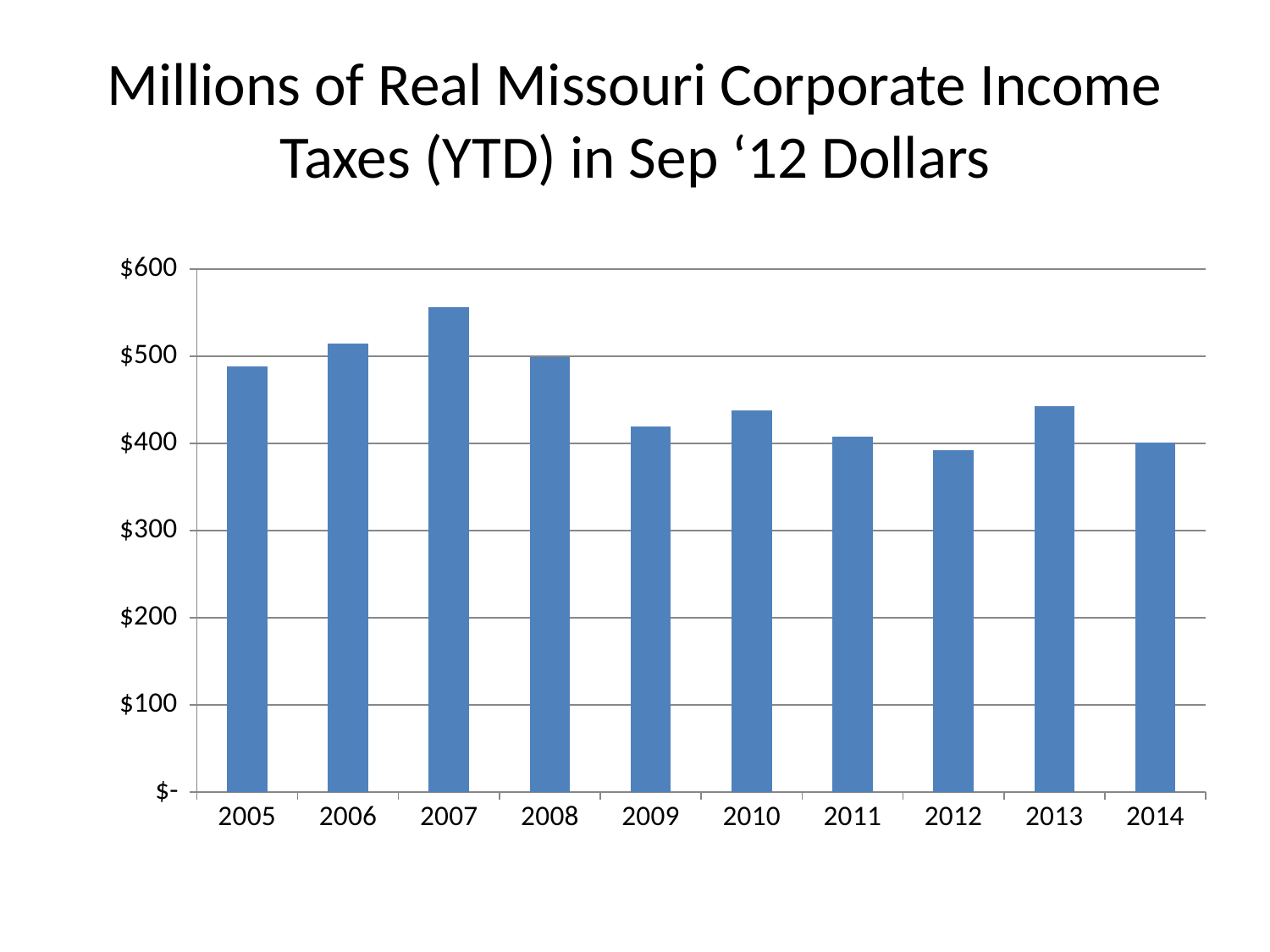
Is the value for 2013 greater or less than $400? greater Which is larger, the value for 2007 or the value for 2012? 2007 Which year has the highest value in the chart? 2007 Is the value for 2009 greater or less than $400? greater What type of chart is shown on the slide? bar chart Is the value for 2007 greater or less than $500? greater What is the title of the chart on the slide? Millions of Real Missouri Corporate Income Taxes (YTD) in Sep '12 Dollars Do the values generally rise or fall from 2007 to 2012? fall Which is larger, the value for 2006 or the value for 2009? 2006 How many years are shown on the x axis of the chart? 10